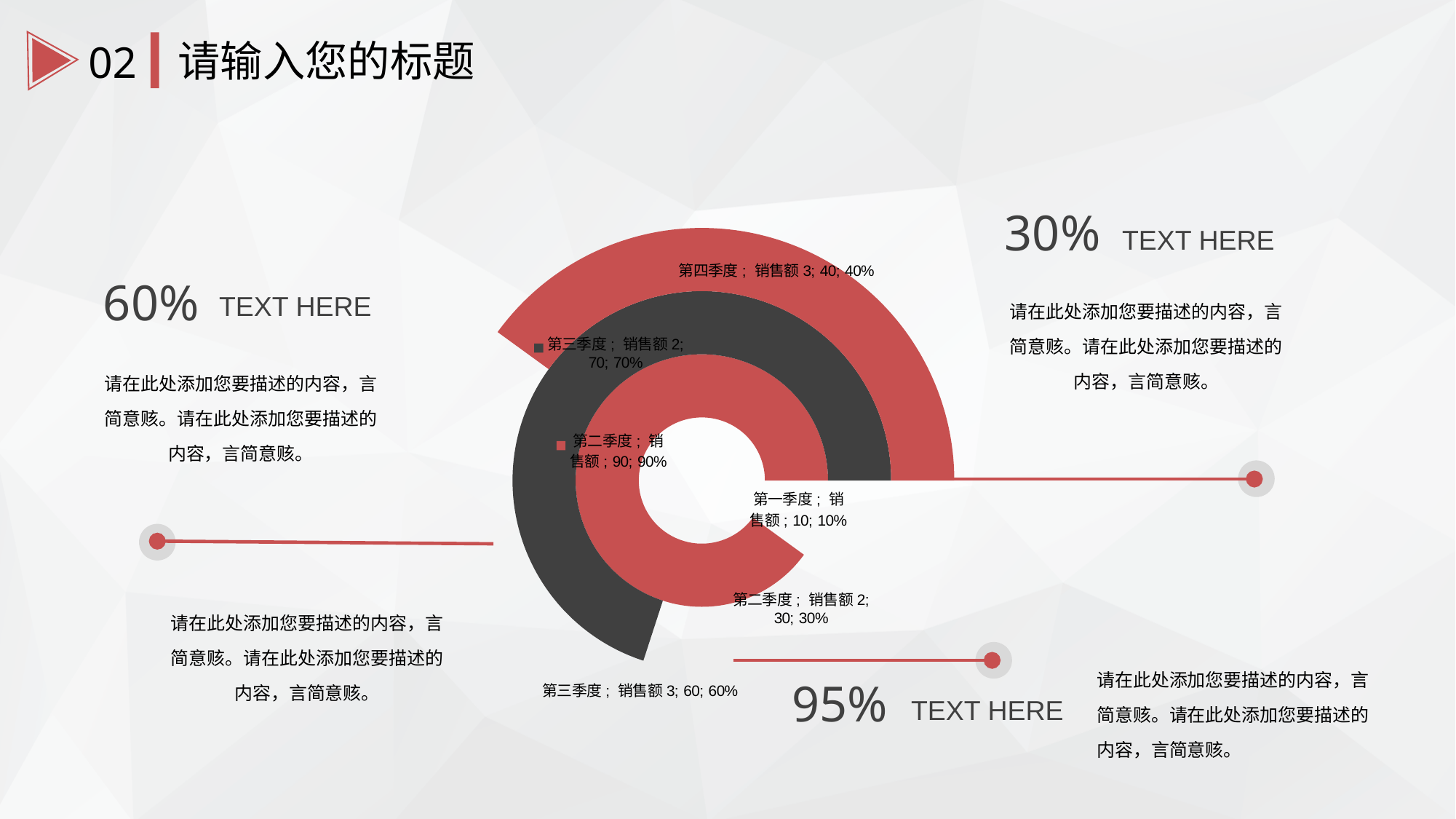
What share of the 销售额 ring does 第一季度 take? 10% What is the value for 第二季度 in the 销售额 2 series? 30 What kind of chart is shown on the slide? doughnut chart What is the value for 第二季度 in the 销售额 series? 90 What is the total of the two labelled values in the 销售额 3 series? 100 Which category has the highest value in the 销售额 2 series? 第三季度 What is the difference between the 第二季度 and 第一季度 values in the 销售额 series? 80 What is the value for 第三季度 in the 销售额 3 series? 60 In the 销售额 3 series, which is larger, 第三季度 or 第四季度? 第三季度 What is the value for 第三季度 in the 销售额 2 series? 70 What is the value for 第一季度 in the 销售额 series? 10 What is the value for 第四季度 in the 销售额 3 series? 40